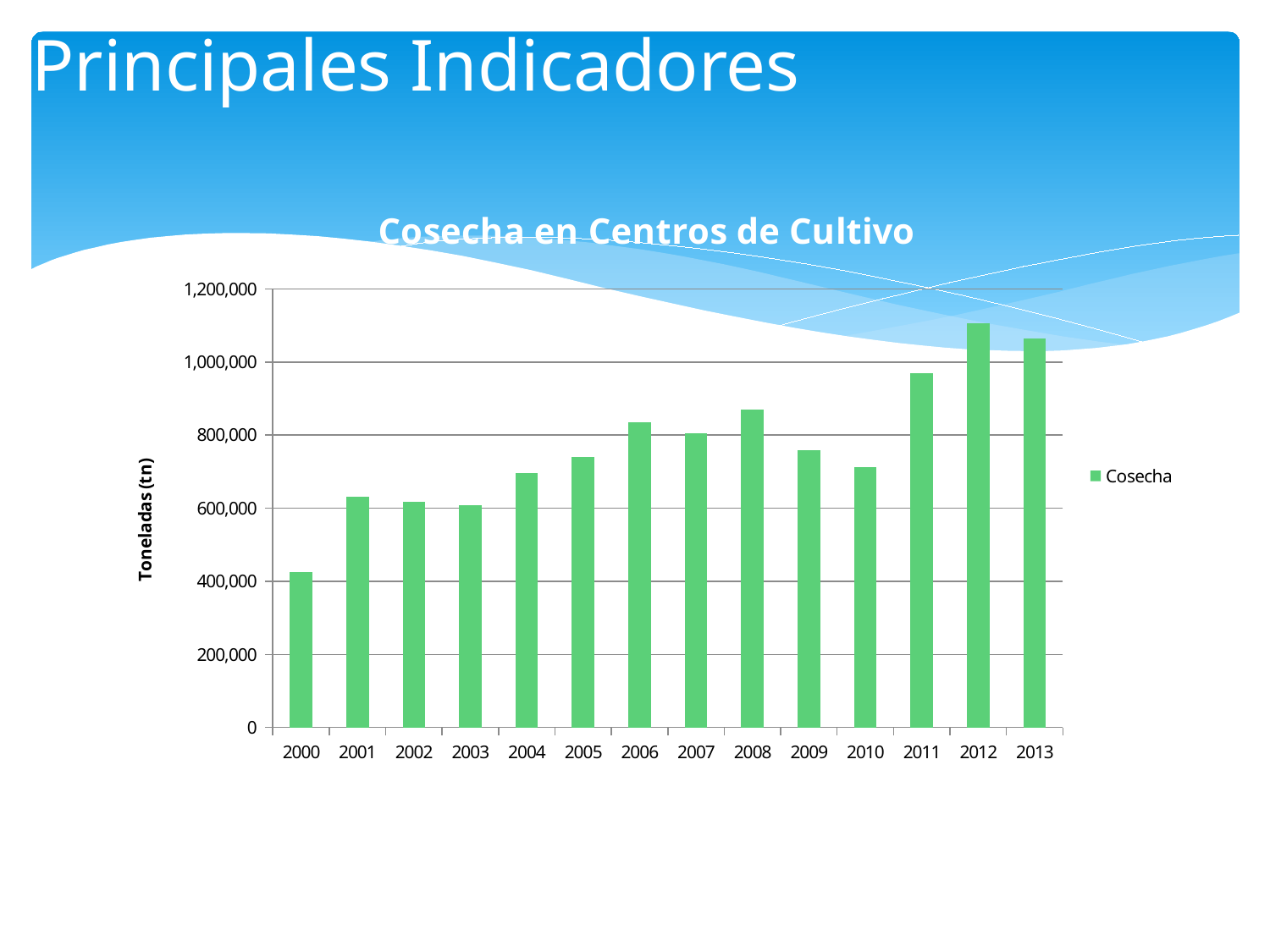
Do the Cosecha values generally rise or fall from 2000 to 2013? Rise Is the Cosecha value for 2010 greater or less than 800,000? less What is the label on the vertical axis of the chart? Toneladas (tn) How many series does the legend list? 1 What is the title of the chart? Cosecha en Centros de Cultivo Is the Cosecha value for 2011 greater or less than 1,000,000? less Which year has the highest Cosecha value? 2012 Is the Cosecha value for 2012 greater or less than 1,000,000? greater Which year has the lowest Cosecha value? 2000 How many years are shown on the x axis of the chart? 14 Which year has a larger Cosecha value, 2008 or 2009? 2008 What kind of chart is shown on the slide? Bar chart